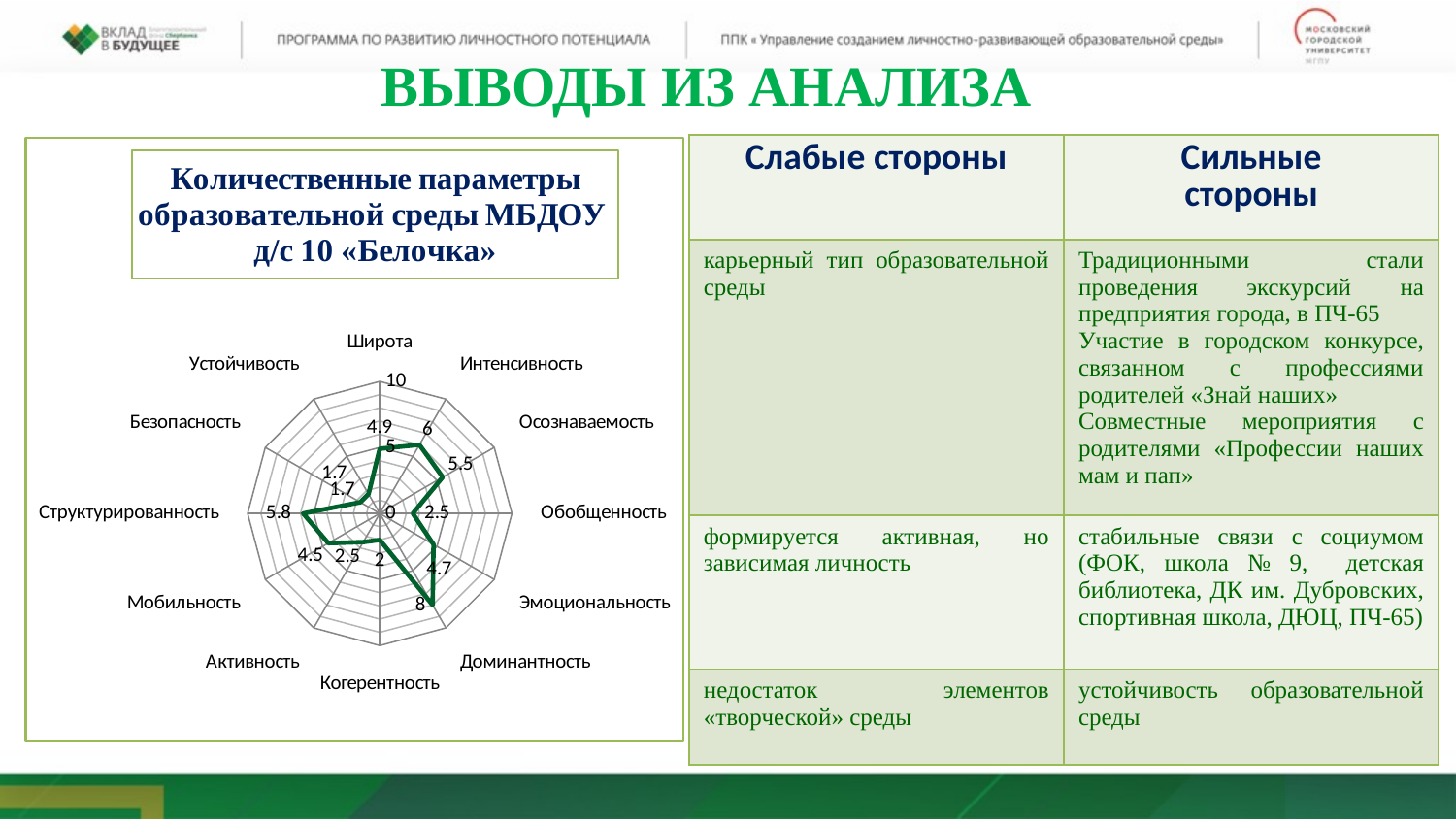
How many parameters (categories) are plotted on the radar chart? 12 What is the value for Доминантность on the radar chart? 8 What is the value for Структурированность on the radar chart? 5.8 Which parameter has the highest value on the radar chart? Доминантность What is the value for Осознаваемость on the radar chart? 5.5 Which is larger on the radar chart: the value for Структурированность or the value for Обобщенность? Структурированность Is the value for Доминантность on the radar chart greater or less than 5? greater What is the maximum value shown on the radar chart's axis scale? 10 What kind of chart is shown on the left side of the slide? Radar chart What is the value for Интенсивность on the radar chart? 6 What is the value for Широта on the radar chart? 4.9 What is the difference between the values for Доминантность and Интенсивность on the radar chart? 2